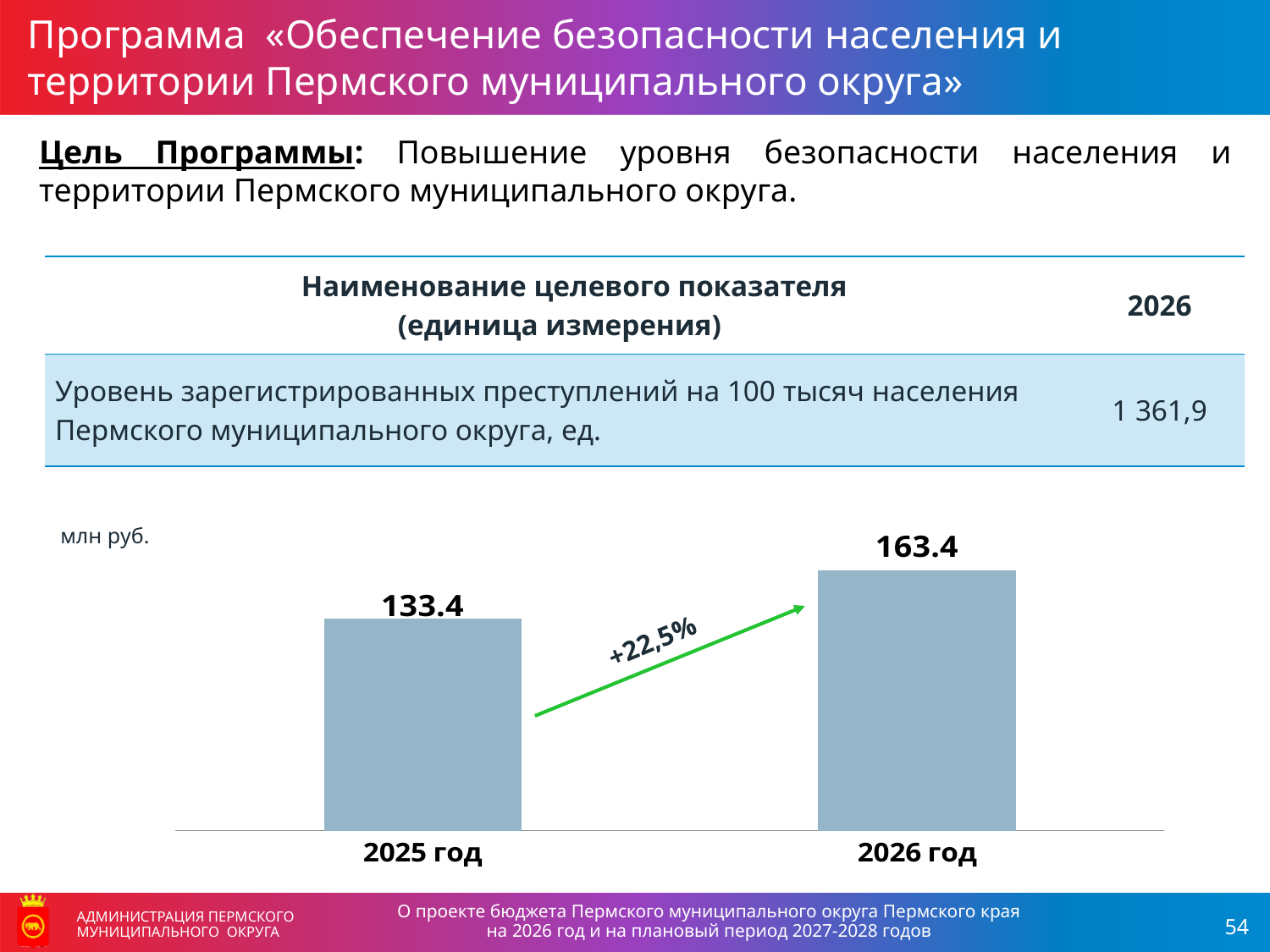
Which year has the higher value in the bar chart? 2026 год Which year has the lower value in the bar chart? 2025 год What type of chart is shown on the slide? bar chart What is the difference between the 2026 год and 2025 год values in the bar chart? 30.0 Is the value for 2026 год larger or smaller than the value for 2025 год? larger What unit of measurement is indicated for the chart values? млн руб. What percentage change is shown on the arrow between the two bars? +22,5% What is the value for 2026 год in the bar chart? 163.4 How many bars are shown in the chart? 2 Do the values rise or fall from 2025 год to 2026 год? rise What is the value for 2025 год in the bar chart? 133.4